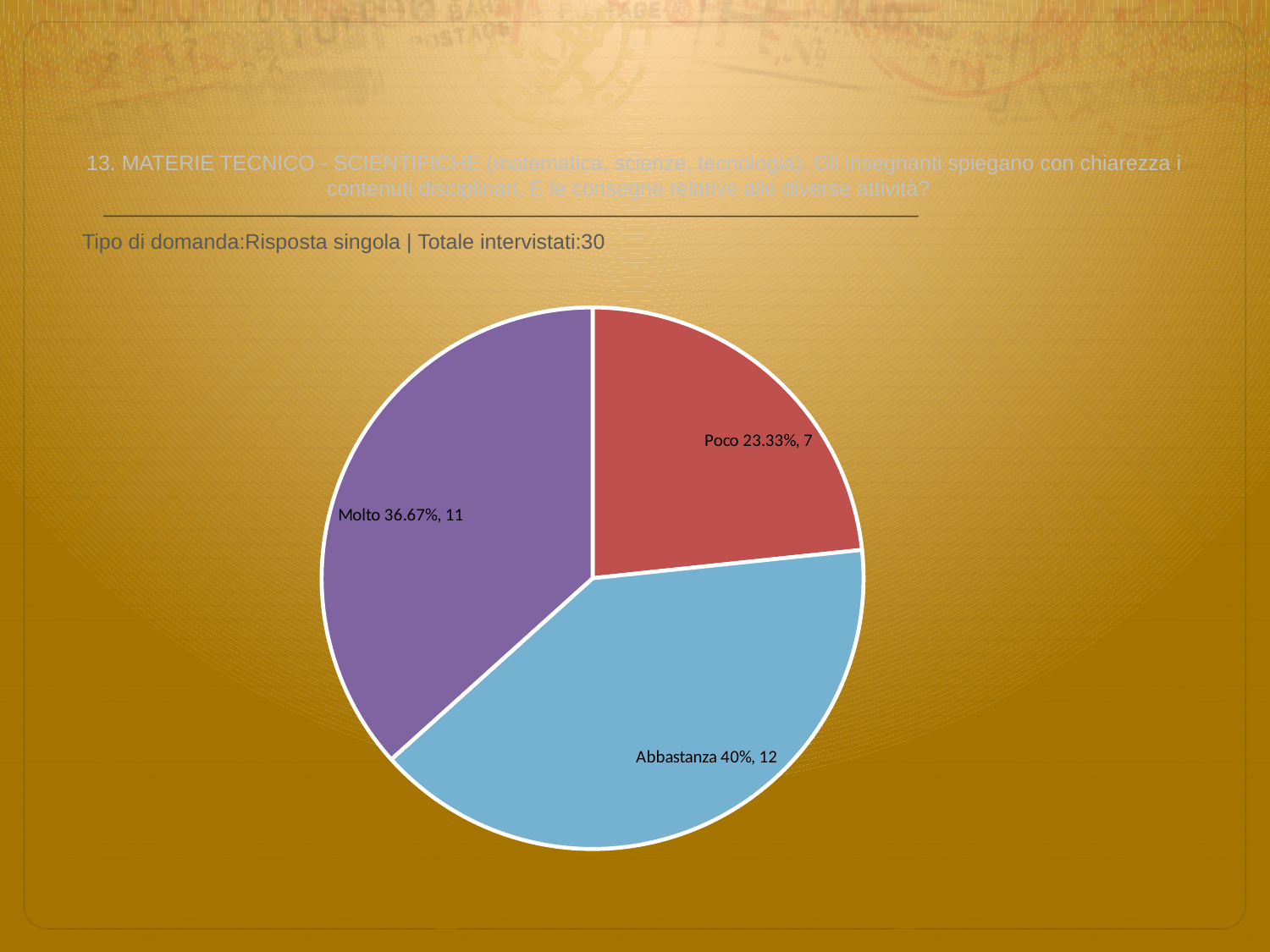
Which category has the largest slice? Abbastanza How many respondents answered Molto? 11 What colour is the Molto slice? purple Which category has the smallest slice? Poco How many slices does the pie chart have? 3 What percentage share does the Molto slice have? 36.67% What percentage share does the Poco slice have? 23.33% What percentage share does the Abbastanza slice have? 40% How many respondents answered Abbastanza? 12 What kind of chart is shown on the slide? pie chart What is the difference in respondent count between Abbastanza and Poco? 5 How many respondents answered Poco? 7